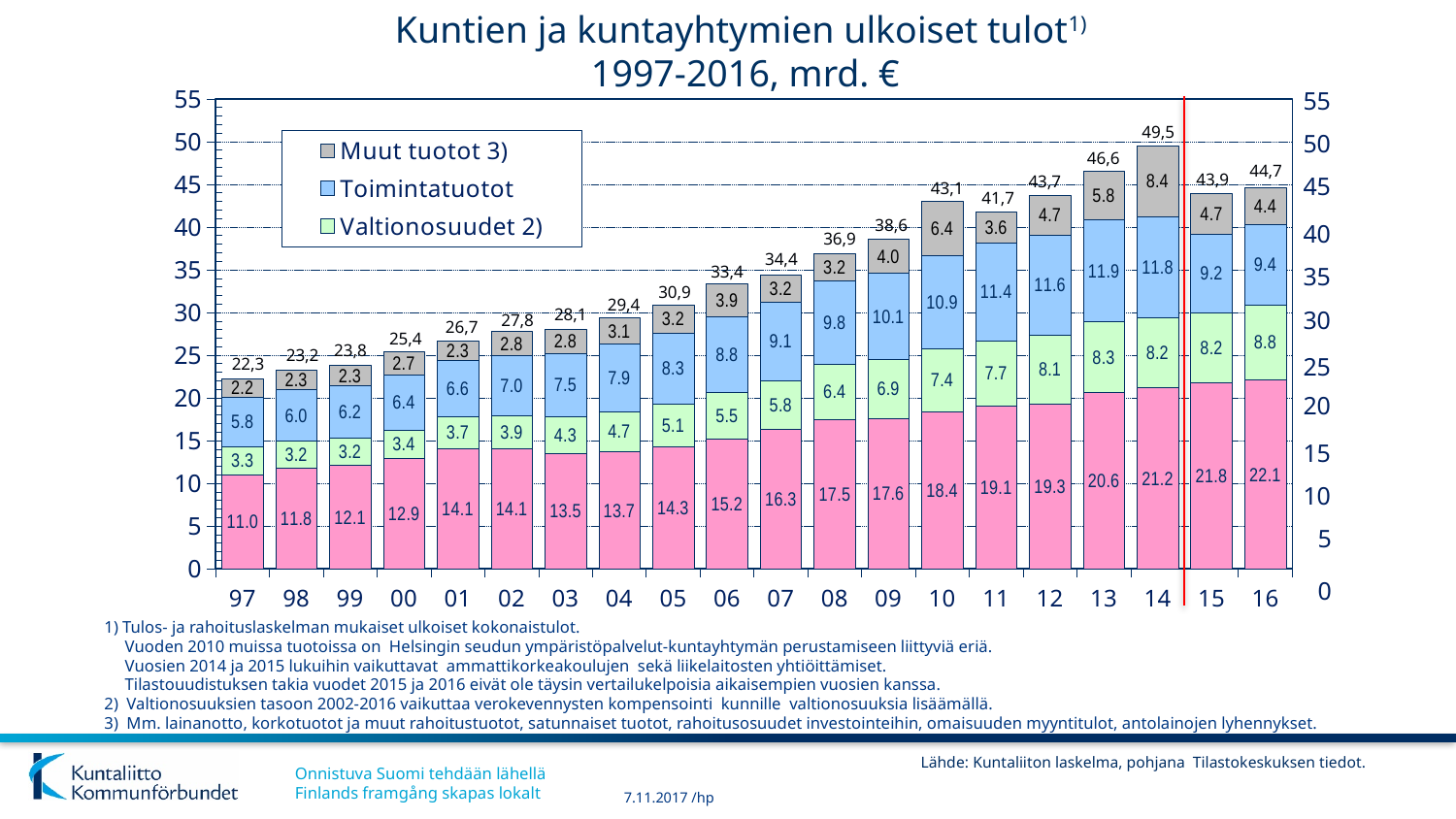
Which year has the highest total bar? 2014 What type of chart is shown on the slide? Stacked bar chart How many years are shown on the x axis? 20 What is the Muut tuotot value for 2014? 8.4 What is the Valtionosuudet value for 2016? 8.8 Which is larger, the Muut tuotot value for 2010 or for 2011? 2010 What is the difference between the Toimintatuotot values for 2013 and 2015? 2.7 Do the Valtionosuudet values rise or fall from 1997 to 2013? Rise Which year has the lowest total bar? 1997 What is the Toimintatuotot value for 2010? 10.9 How many series does the legend list? 3 What is the total value of the bar for 2014? 49,5